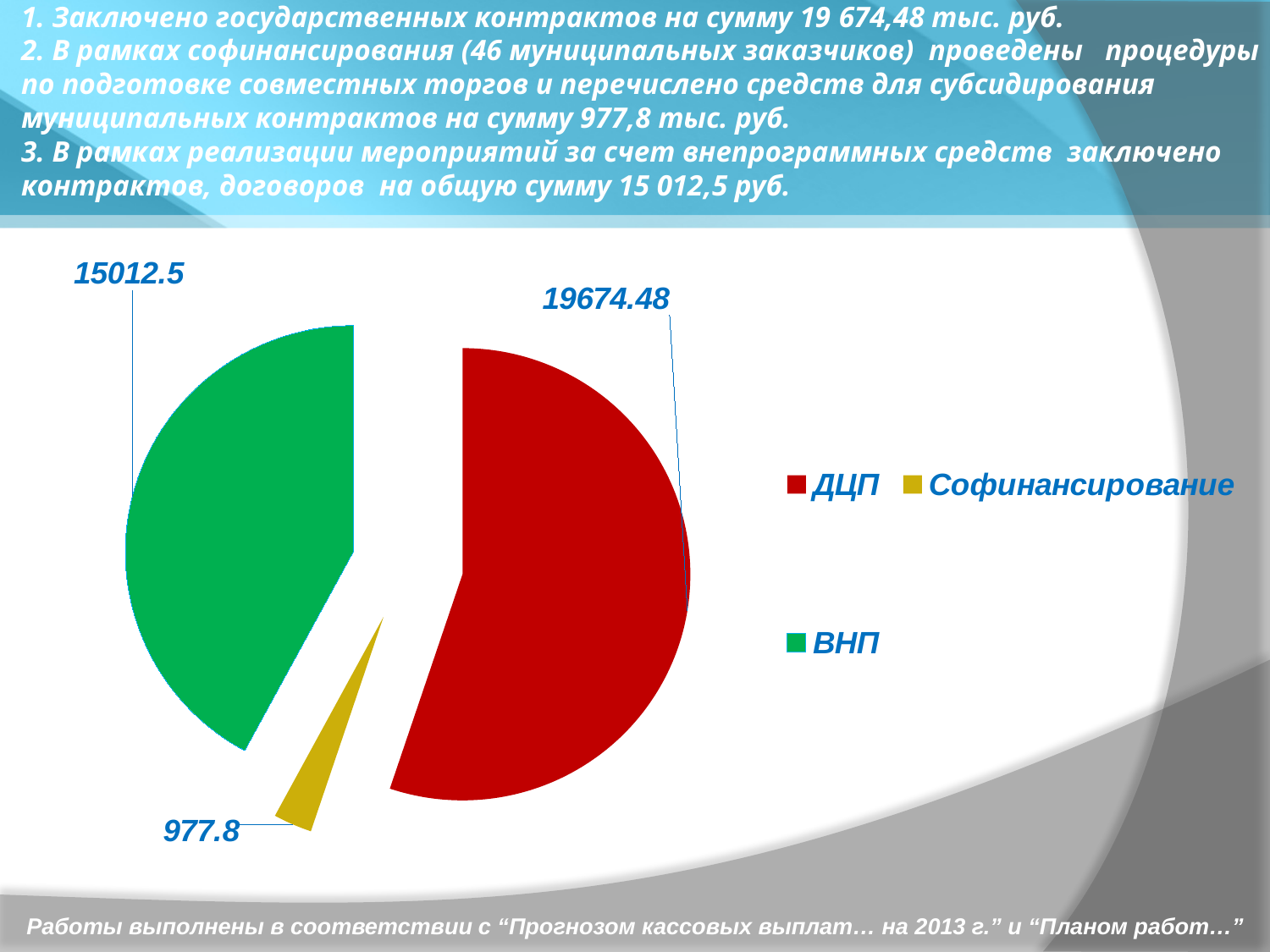
What is the difference between the values for ДЦП and ВНП? 4661.98 Which category has the smallest slice in the pie chart? Софинансирование What is the difference between the values for ВНП and Софинансирование? 14034.7 Which category has the largest slice in the pie chart? ДЦП How many slices does the pie chart have? 3 What is the value for Софинансирование in the pie chart? 977.8 What kind of chart is shown on the slide? pie chart Which is larger, the value for ДЦП or the value for ВНП? ДЦП What is the value for ВНП in the pie chart? 15012.5 How many entries does the legend of the pie chart list? 3 What is the value for ДЦП in the pie chart? 19674.48 What colour is the slice for ВНП in the pie chart? green